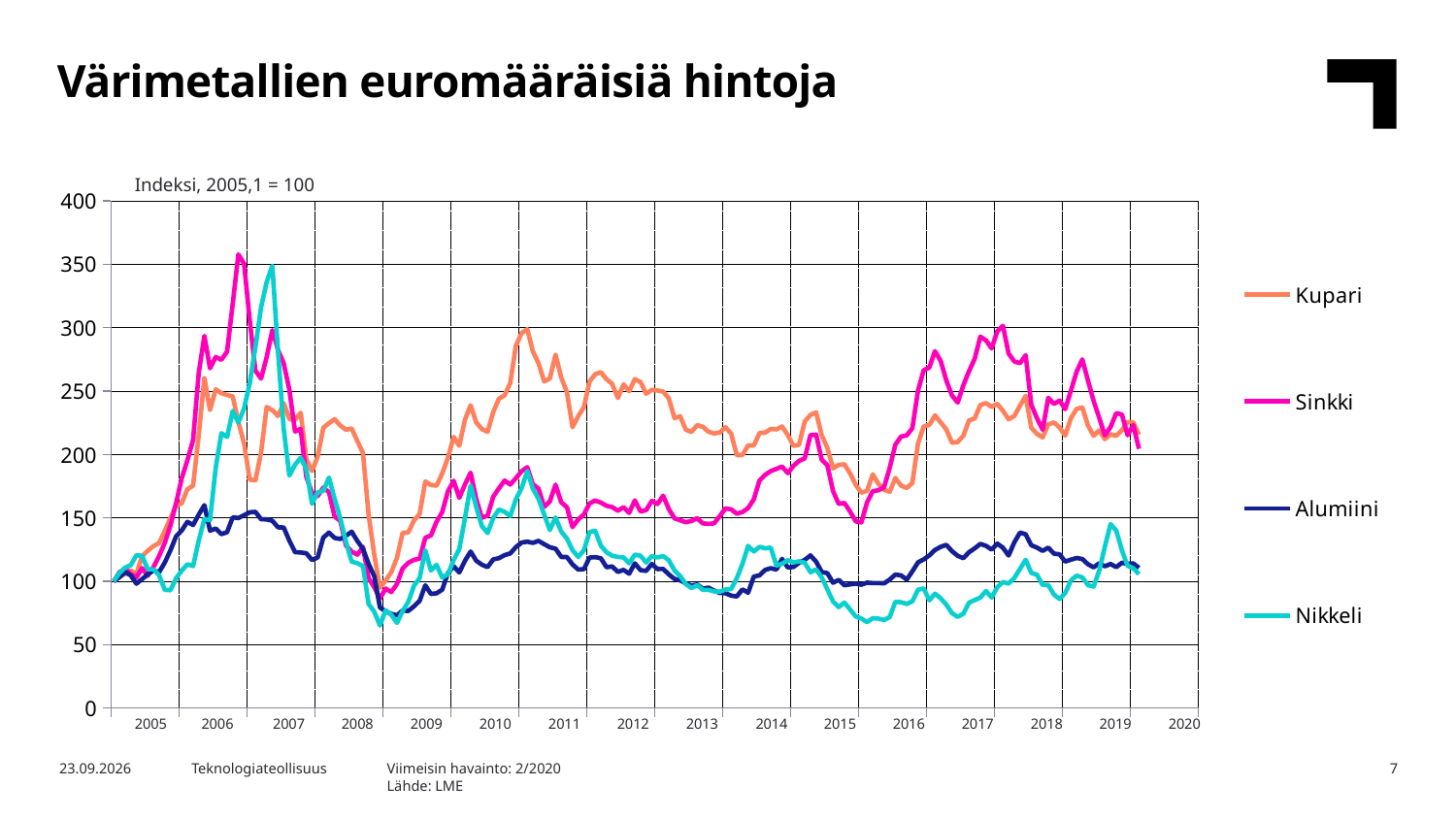
Around 2010, which series is higher: Kupari or Alumiini? Kupari Is the peak value of Sinkki in 2006 greater or less than 300? greater What kind of chart is shown on the slide? Line chart Which series is drawn in orange according to the legend? Kupari How many series does the legend list? 4 Does the Nikkeli series rise or fall between 2007 and 2008? Fall Is the value of Nikkeli at the start of 2016 greater or less than 100? less What is the title of the chart? Värimetallien euromääräisiä hintoja At the 2006 peak, which series is higher: Sinkki or Alumiini? Sinkki Does the Kupari series rise or fall between 2005 and 2006? Rise Is the peak value of Kupari around 2010 greater or less than 250? greater